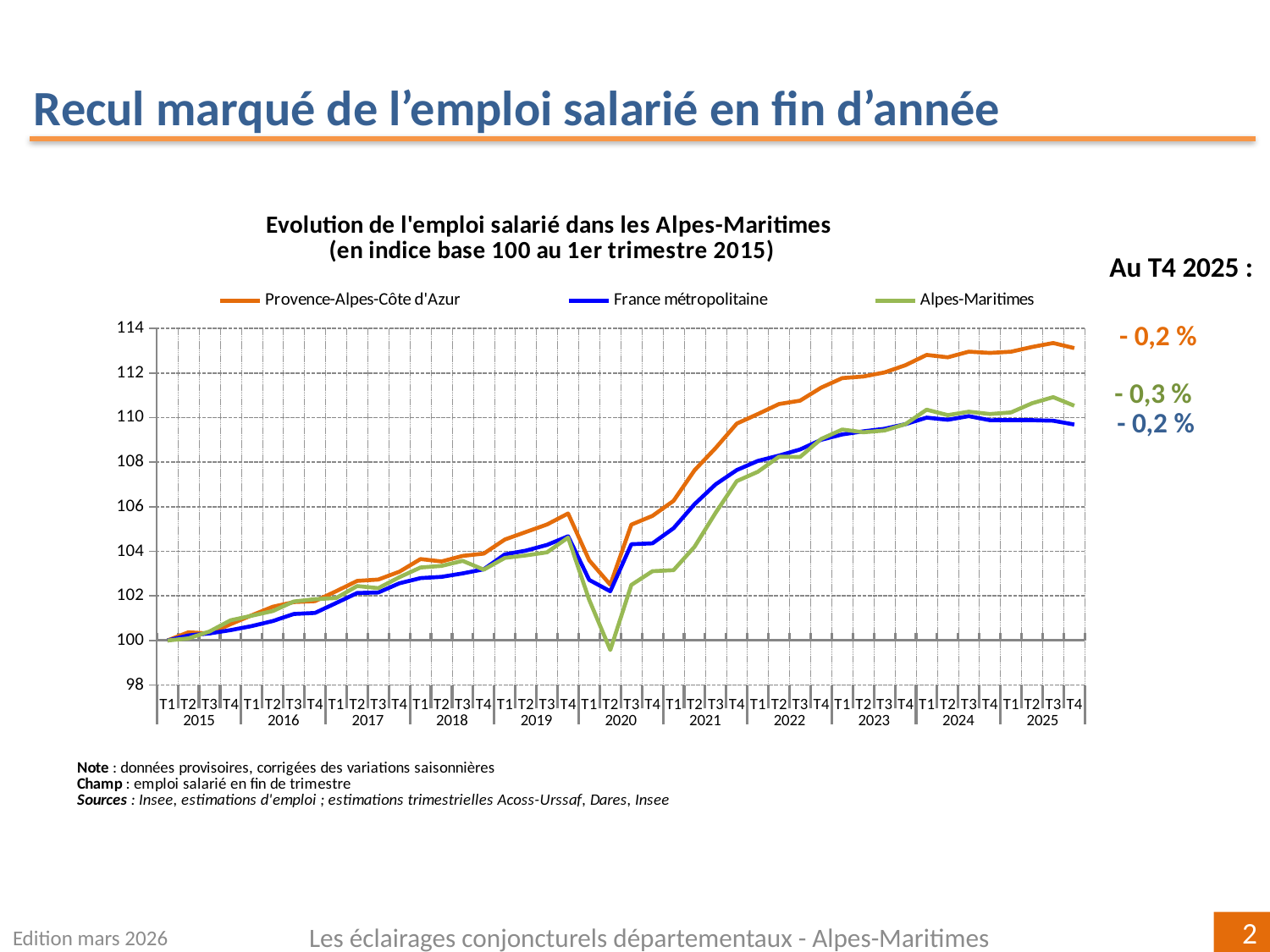
How many series does the legend list? 3 Overall, do the series rise or fall between 2015 and 2025? rise What is the index value of all three series at T1 2015? 100 Is the value for Provence-Alpes-Côte d'Azur at T4 2025 greater or less than 112? greater Which three series are listed in the legend? Provence-Alpes-Côte d'Azur, France métropolitaine, Alpes-Maritimes How many years are shown on the x axis? 11 Which series has the lowest value at T2 2020? Alpes-Maritimes Is the value for France métropolitaine at T4 2025 greater or less than 108? greater At T4 2025, which is higher: Alpes-Maritimes or France métropolitaine? Alpes-Maritimes Is the value for Alpes-Maritimes at T2 2020 greater or less than 100? less What kind of chart is shown on the slide? line chart Which series has the highest value at T4 2025? Provence-Alpes-Côte d'Azur